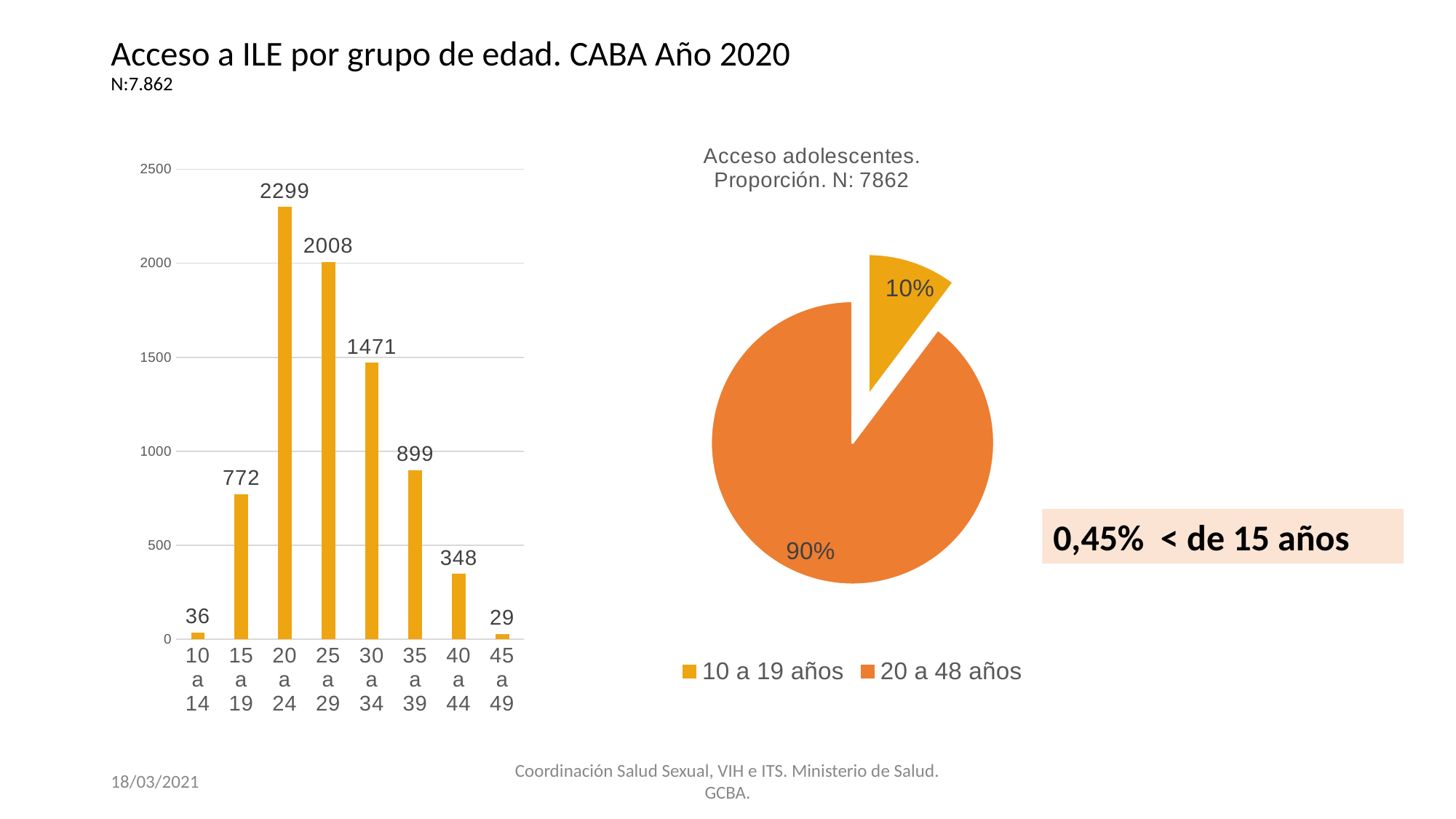
In the bar chart on the left, what is the difference between the values for 20 a 24 and 25 a 29? 291 What kind of chart is the chart on the left? bar chart In the bar chart on the left, what is the value for the 35 a 39 age group? 899 In the pie chart titled 'Acceso adolescentes. Proporción. N: 7862', what share does the 20 a 48 años slice have? 90% How many entries does the legend of the pie chart list? 2 In the bar chart on the left, what is the value for the 20 a 24 age group? 2299 In the bar chart on the left, which age group has the highest value? 20 a 24 In the bar chart on the left, how many age groups are shown? 8 In the bar chart on the left, which is larger: the value for 15 a 19 or the value for 35 a 39? 35 a 39 In the pie chart titled 'Acceso adolescentes. Proporción. N: 7862', what share does the 10 a 19 años slice have? 10% What kind of chart is the chart on the right? pie chart In the bar chart on the left, which age group has the lowest value? 45 a 49